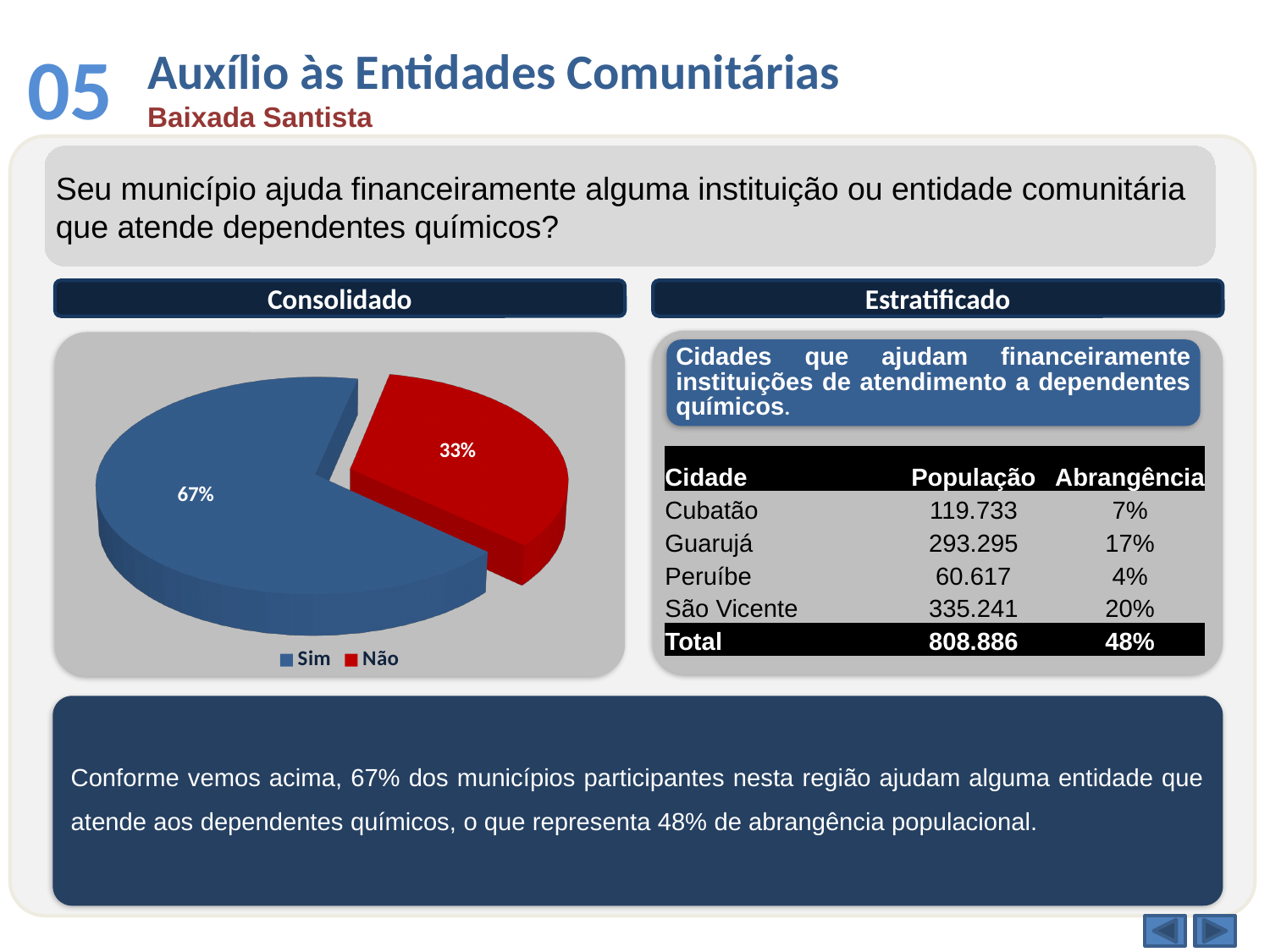
How many slices does the pie chart have? 2 Is the "Sim" share in the pie chart greater or less than 50%? greater What share of the pie chart does "Não" represent? 33% What colour is the "Não" slice in the pie chart? red What share of the pie chart does "Sim" represent? 67% How many entries does the pie chart's legend list? 2 What colour is the "Sim" slice in the pie chart? blue What kind of chart is shown under "Consolidado"? pie chart What is the difference in percentage points between the "Sim" and "Não" slices of the pie chart? 34 Which slice of the pie chart is the largest? Sim Which slice of the pie chart is the smallest? Não Which is larger in the pie chart, "Sim" or "Não"? Sim